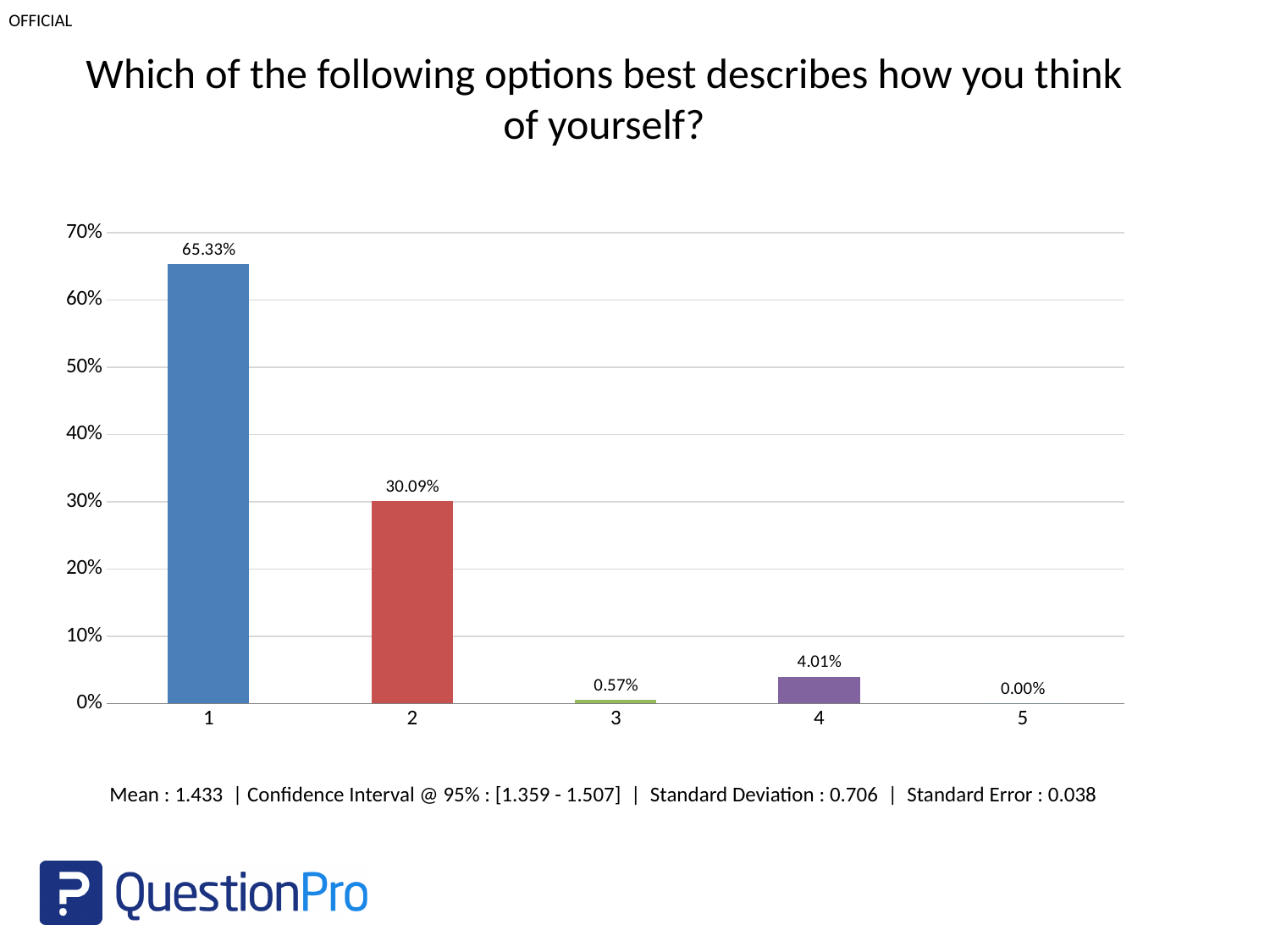
What is the value for category 1? 65.33% Which category has the highest value? 1 What is the value for category 5? 0.00% Is the value for category 2 greater or less than 40%? less Which category has the lowest value? 5 What kind of chart is shown on the slide? bar chart What is the value for category 3? 0.57% Which is larger, the value for category 3 or category 4? 4 How many categories are shown on the x axis? 5 What is the difference between the values for category 1 and category 2? 35.24% What is the value for category 4? 4.01% What is the value for category 2? 30.09%